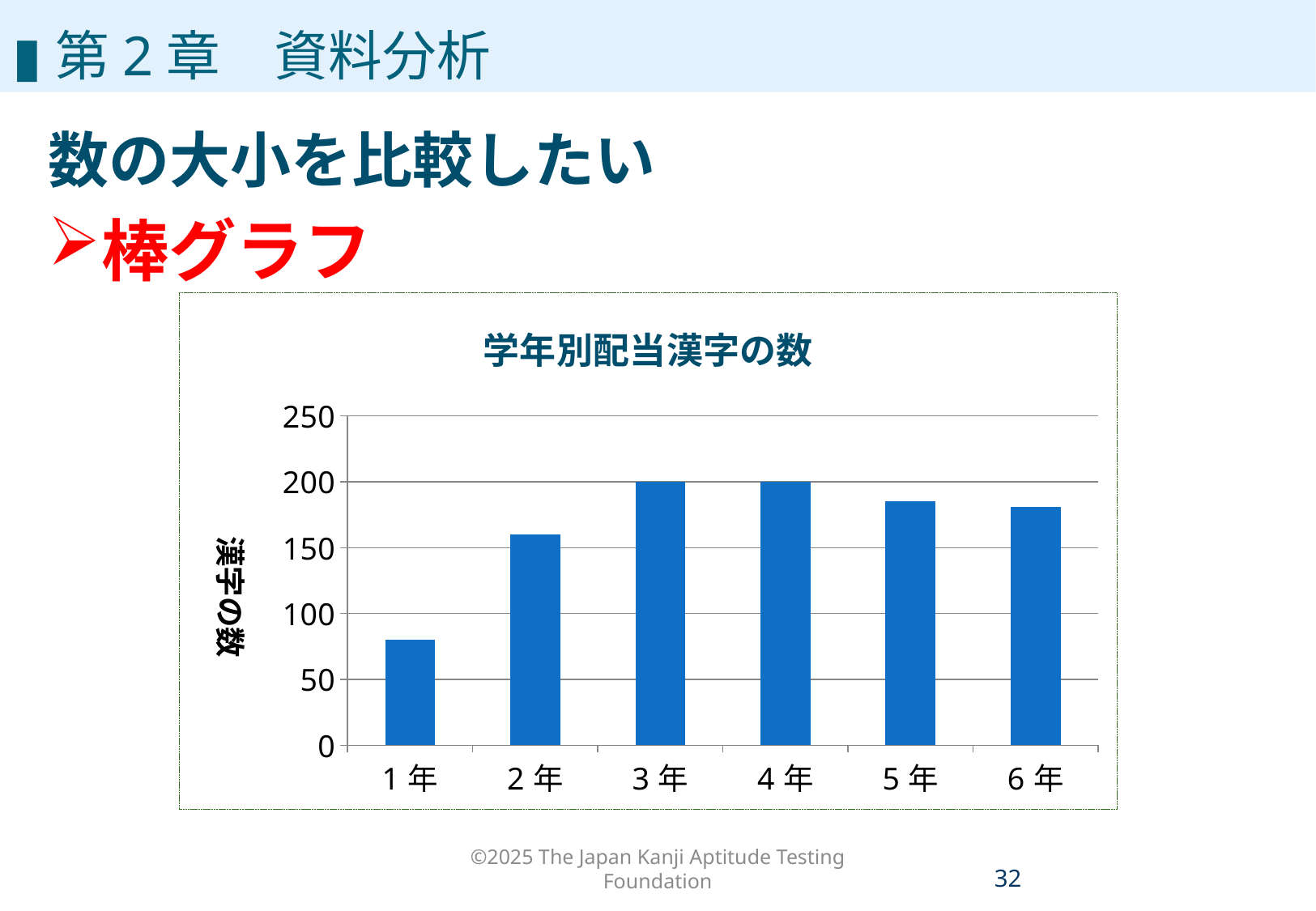
Which is larger, the value for 1年 or the value for 2年? 2年 Do the values rise or fall from 1年 to 3年? rise What is the value for 3年? 200 What is the title of the chart? 学年別配当漢字の数 What is the label on the vertical axis of the chart? 漢字の数 Is the value for 2年 greater or less than 150? greater How many grade categories are shown on the x axis? 6 Is the value for 6年 greater or less than 200? less Which grade has the lowest number of kanji? 1年 What kind of chart is shown on the slide? bar chart What is the value for 4年? 200 Is the value for 1年 greater or less than 100? less